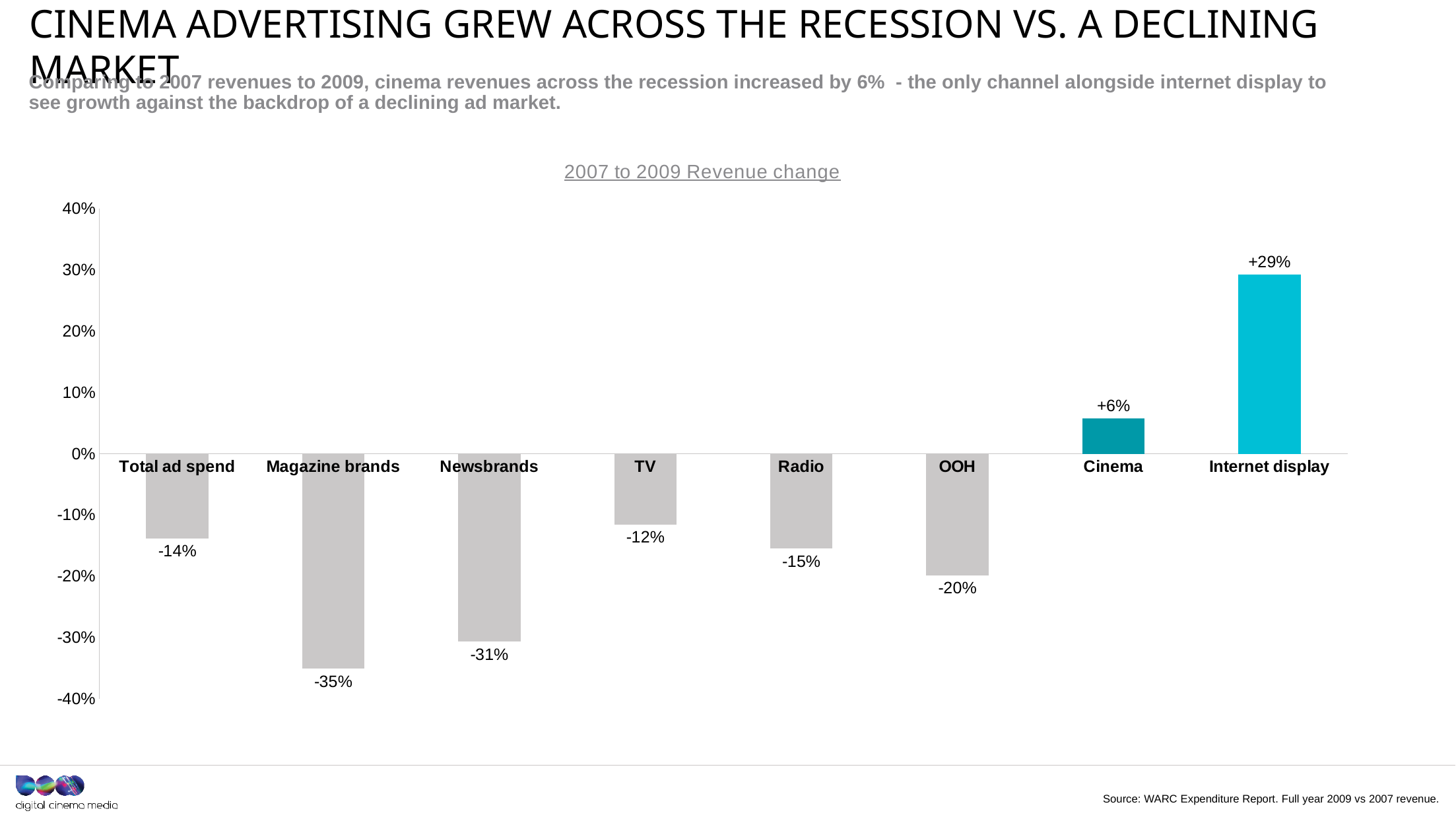
What kind of chart is shown on the slide? Bar chart What is the revenue change shown for Total ad spend? -14% Which category has the highest revenue change? Internet display Which category has the lowest revenue change? Magazine brands How many categories are shown in the chart? 8 What is the 2007 to 2009 revenue change for Cinema? +6% Is the value for Newsbrands greater or less than -30%? less What is the title of the chart? 2007 to 2009 Revenue change What is the revenue change shown for OOH? -20% What is the 2007 to 2009 revenue change for Magazine brands? -35% What is the difference between the revenue change for Internet display and Cinema? 23 percentage points Which has a larger decline in revenue, TV or Radio? Radio